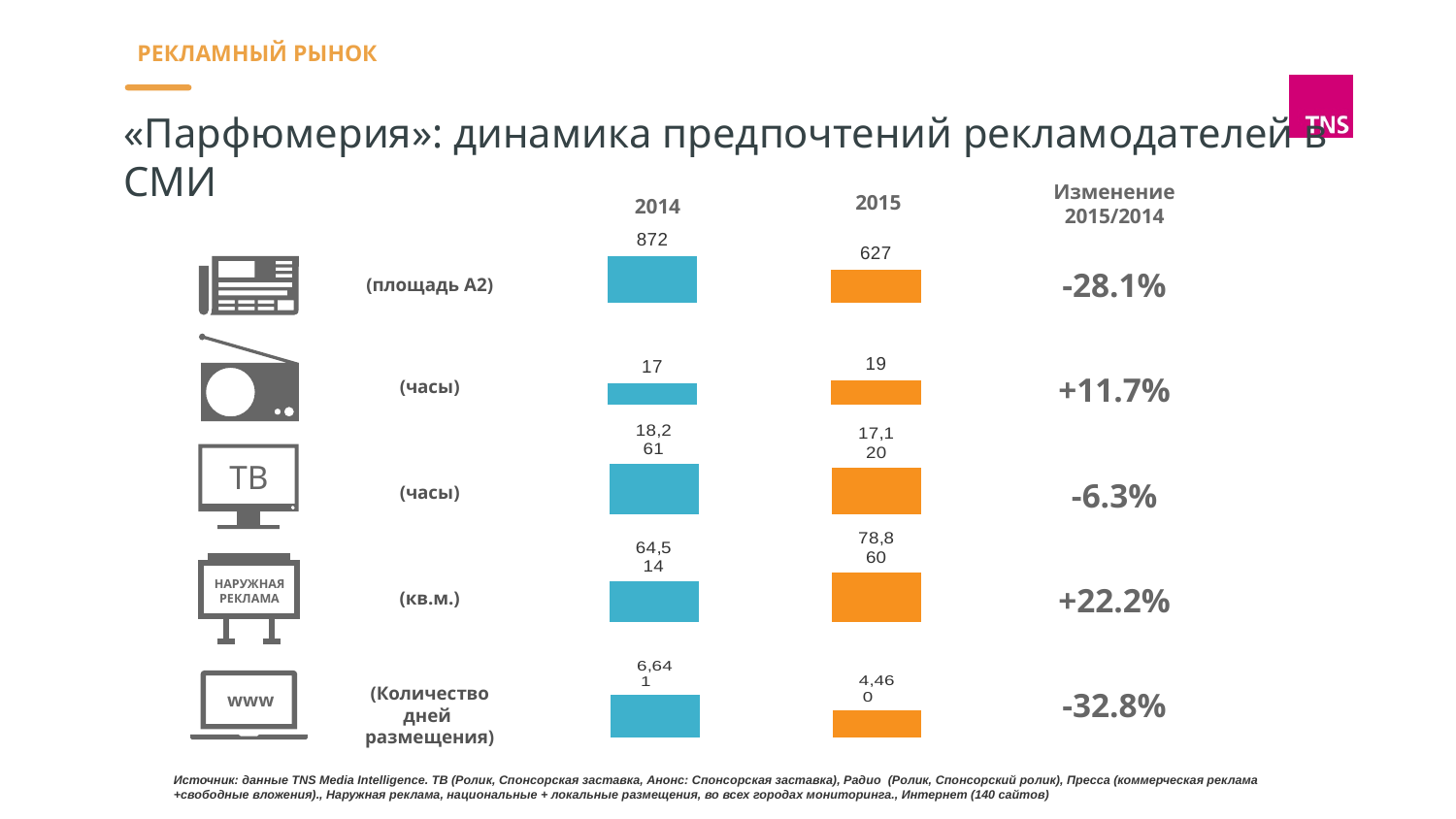
What is the Изменение 2015/2014 value for the (площадь A2) row? -28.1% What is the 2014 value for the radio row (second row, часы)? 17 What is the Изменение 2015/2014 value for the www row? -32.8% How many media rows are shown in the chart? 5 What is the 2015 value for the (площадь A2) row? 627 Which row shows the largest decline in the Изменение 2015/2014 column? www (-32.8%) What is the 2015 value for the radio row (second row, часы)? 19 In the (площадь A2) row, which year has the larger value, 2014 or 2015? 2014 What is the 2014 value for the (площадь A2) row? 872 What is the Изменение 2015/2014 value for the ТВ row? -6.3% What is the Изменение 2015/2014 value for the НАРУЖНАЯ РЕКЛАМА row? +22.2% What is the difference between the 2014 and 2015 values in the (площадь A2) row? 245